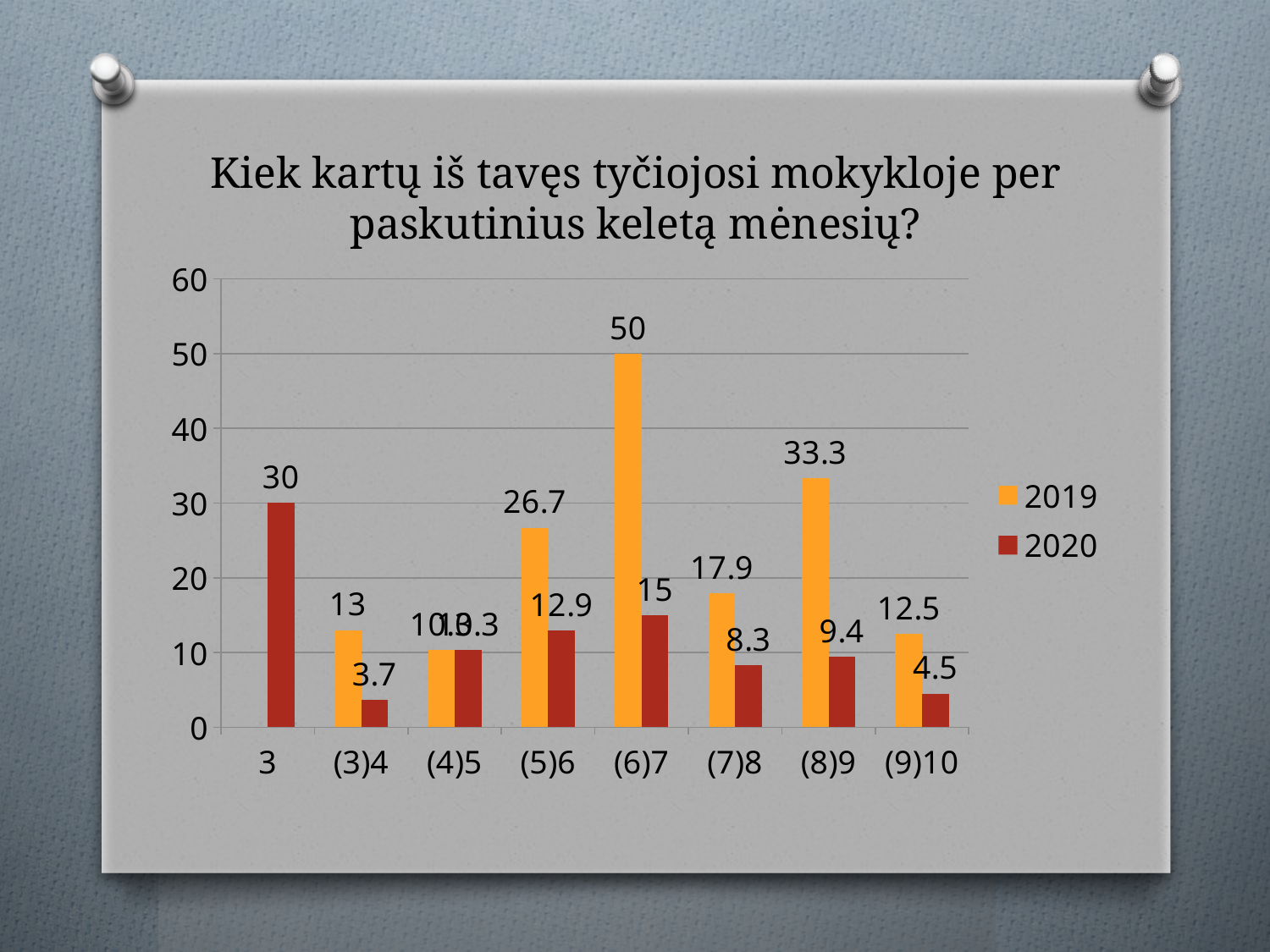
How many categories are shown on the x axis? 8 What is the 2019 value for category (8)9? 33.3 What is the 2019 value for category (6)7? 50 Which category has the lowest 2020 value? (3)4 Is the 2019 value for category (7)8 greater or less than 20? less Which category has the highest 2019 value? (6)7 What is the 2020 value for category 3? 30 How many series does the legend list? 2 Which is larger for category (5)6: the 2019 value or the 2020 value? 2019 What is the difference between the 2019 and 2020 values for category (6)7? 35 What kind of chart is shown on the slide? bar chart What is the 2020 value for category (9)10? 4.5